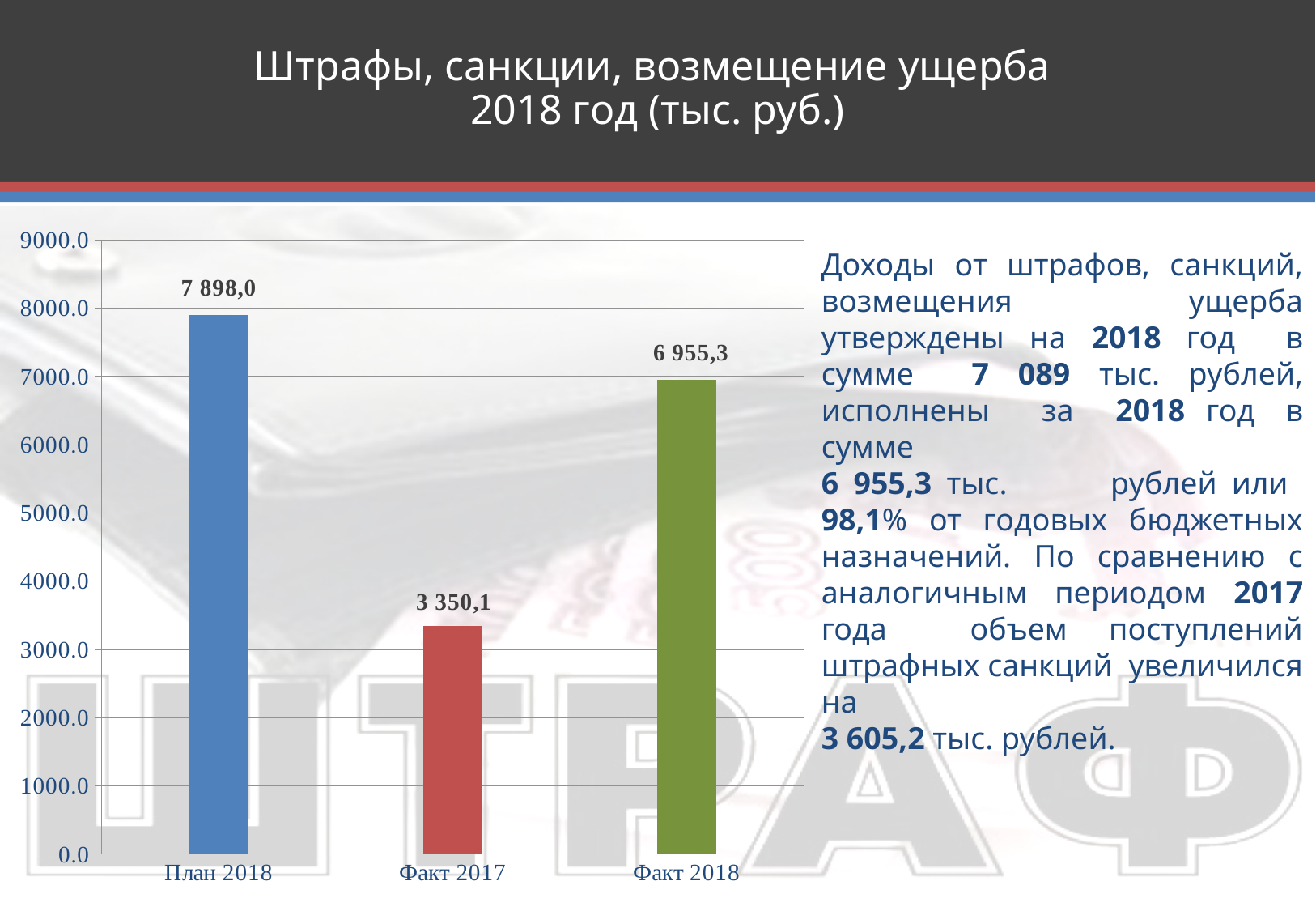
What is the difference between Факт 2018 and Факт 2017? 3 605,2 What is the value for План 2018? 7 898,0 Which category has the highest value? План 2018 Which category has the lowest value? Факт 2017 What is the difference between План 2018 and Факт 2018? 942,7 Is the value for Факт 2017 greater or less than 4000? less What is the value for Факт 2017? 3 350,1 How many bars are shown in the chart? 3 Which is larger, Факт 2017 or Факт 2018? Факт 2018 What colour is the bar for Факт 2018? green What is the value for Факт 2018? 6 955,3 What kind of chart is shown on the slide? bar chart